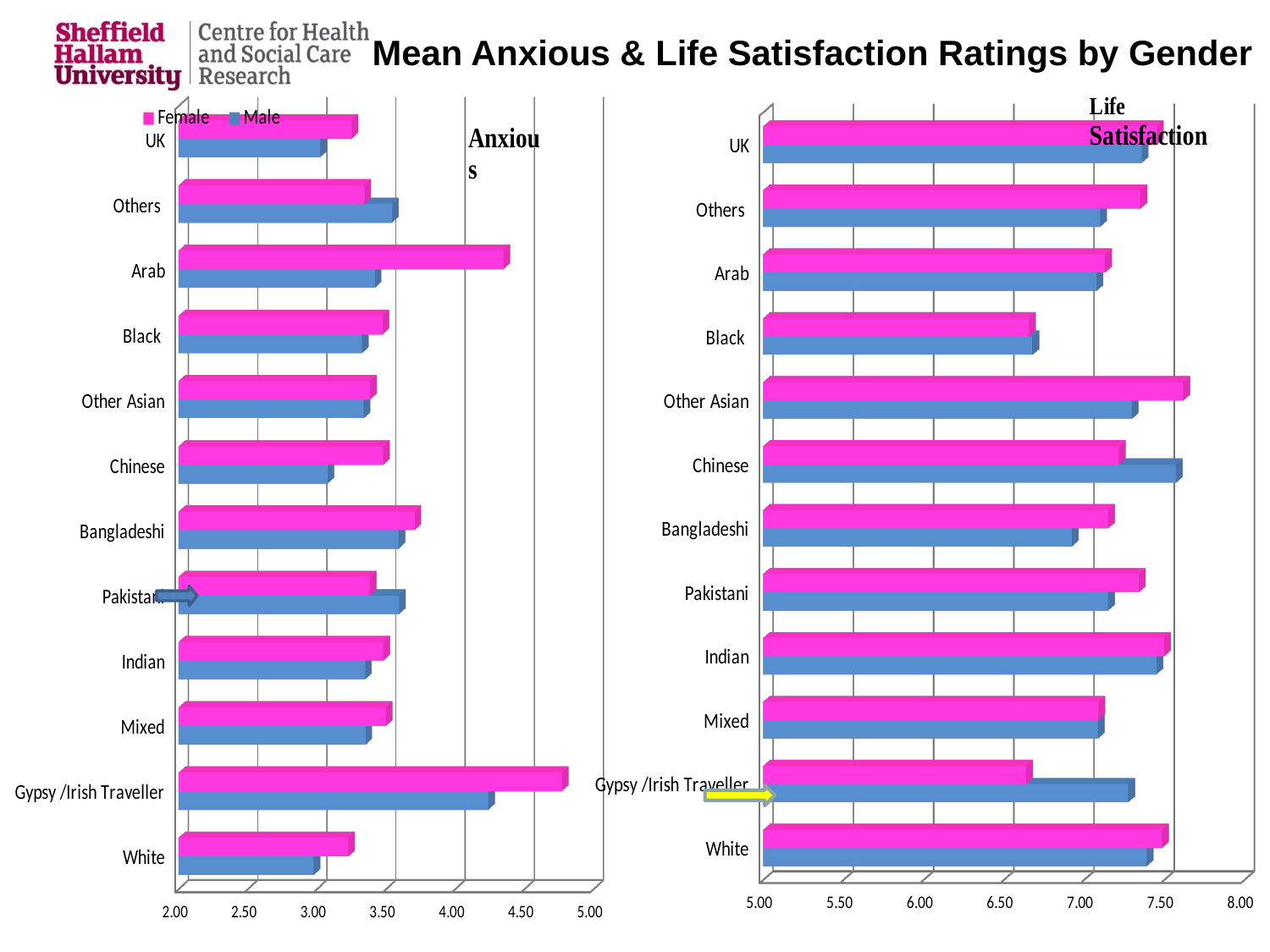
What kind of chart is the Anxious chart on the left of the slide? Bar chart In the Life Satisfaction chart, which category has the lowest Male value? Black In the Life Satisfaction chart, which is larger for Chinese, the Female value or the Male value? Male In the Anxious chart, which is larger for Arab, the Female value or the Male value? Female In the Anxious chart, is the Female value for Gypsy /Irish Traveller greater or less than 4.50? greater How many ethnic group categories are shown in the Life Satisfaction chart? 12 In the Life Satisfaction chart, is the Female value for Black greater or less than 7.00? less In the Anxious chart, which category has the highest Female value? Gypsy /Irish Traveller In the Anxious chart, is the Female value for Arab greater or less than 4.00? greater In the Anxious chart, which colour represents the Female series? Pink How many series does the legend of the Anxious chart list? 2